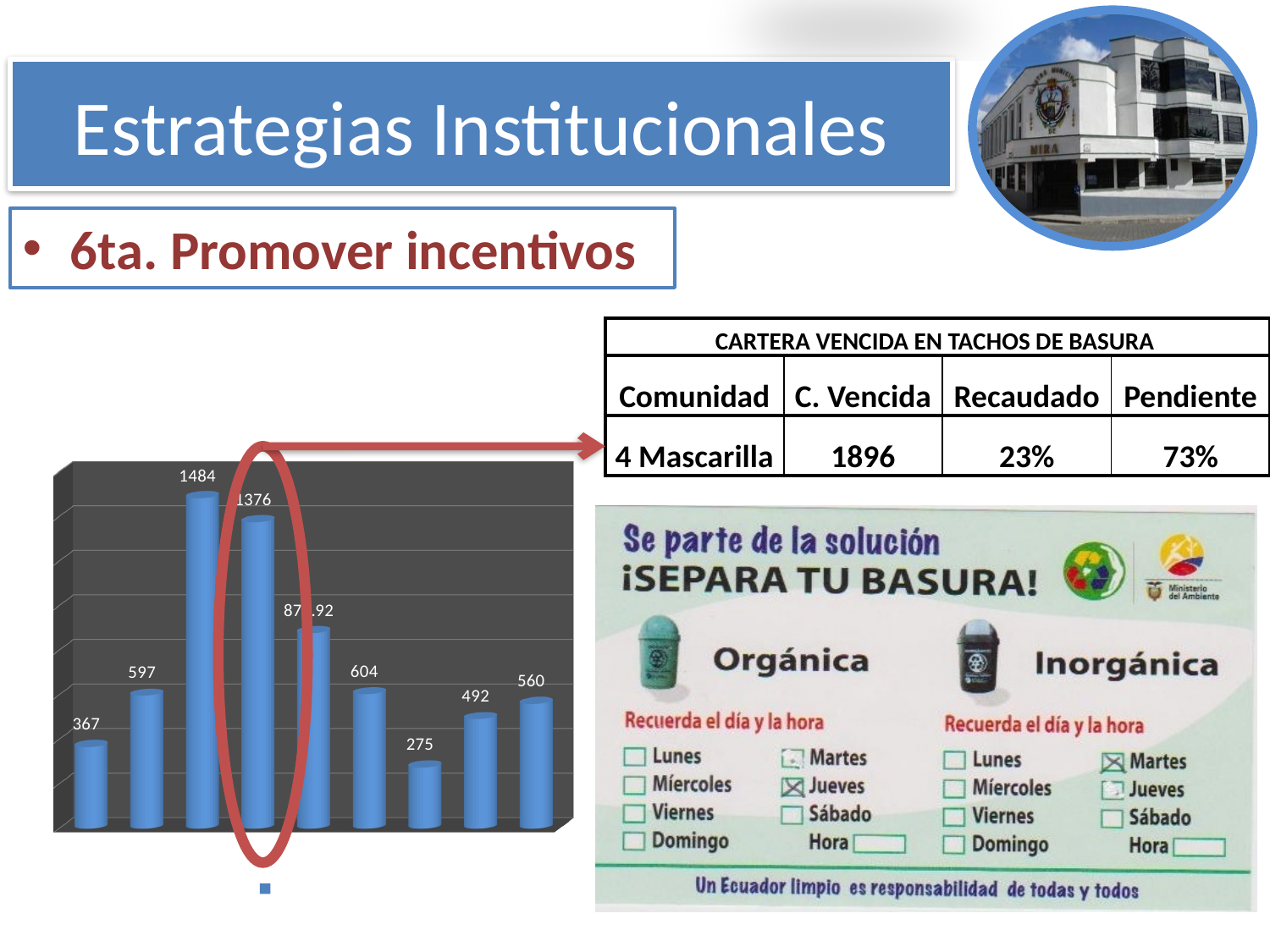
In the bar chart, which is larger: the first bar (367) or the last bar (560)? the last bar (560) What is the value of the tallest bar in the bar chart? 1484 What kind of chart is shown on the left of the slide? bar chart How many bars are plotted in the bar chart on the left of the slide? 9 What is the value of the last bar on the right in the bar chart? 560 What is the difference between the tallest bar (1484) and the shortest bar (275) in the bar chart? 1209 What is the value of the second bar from the left in the bar chart? 597 What is the value of the first bar from the left in the bar chart? 367 What is the value of the shortest bar in the bar chart? 275 What is the difference between the tallest bar (1484) and the circled bar (1376) in the bar chart? 108 Which bar in the bar chart is highlighted with a red oval? the fourth bar from the left What is the value of the bar circled in red in the bar chart? 1376